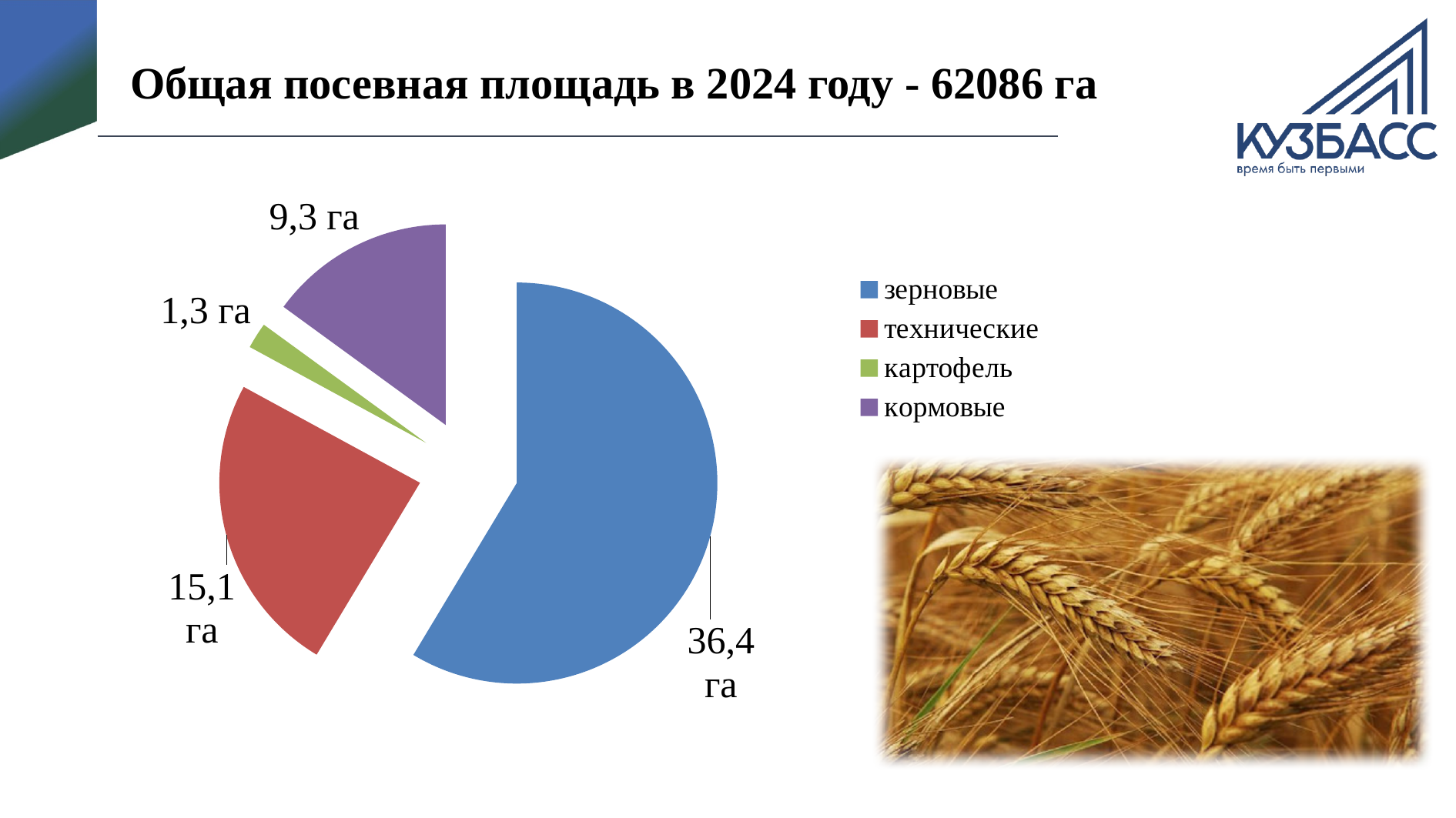
What is the title of the slide containing the chart? Общая посевная площадь в 2024 году - 62086 га How many categories does the legend list? 4 What kind of chart is shown on the slide? pie chart What is the value shown for зерновые? 36,4 га What is the value shown for кормовые? 9,3 га What is the difference between the values for технические and кормовые? 5,8 га Which is larger, the value for кормовые or the value for картофель? кормовые What is the value shown for технические? 15,1 га Which category has the smallest slice of the pie? картофель What is the value shown for картофель? 1,3 га What is the difference between the values for зерновые and технические? 21,3 га Which category has the largest slice of the pie? зерновые